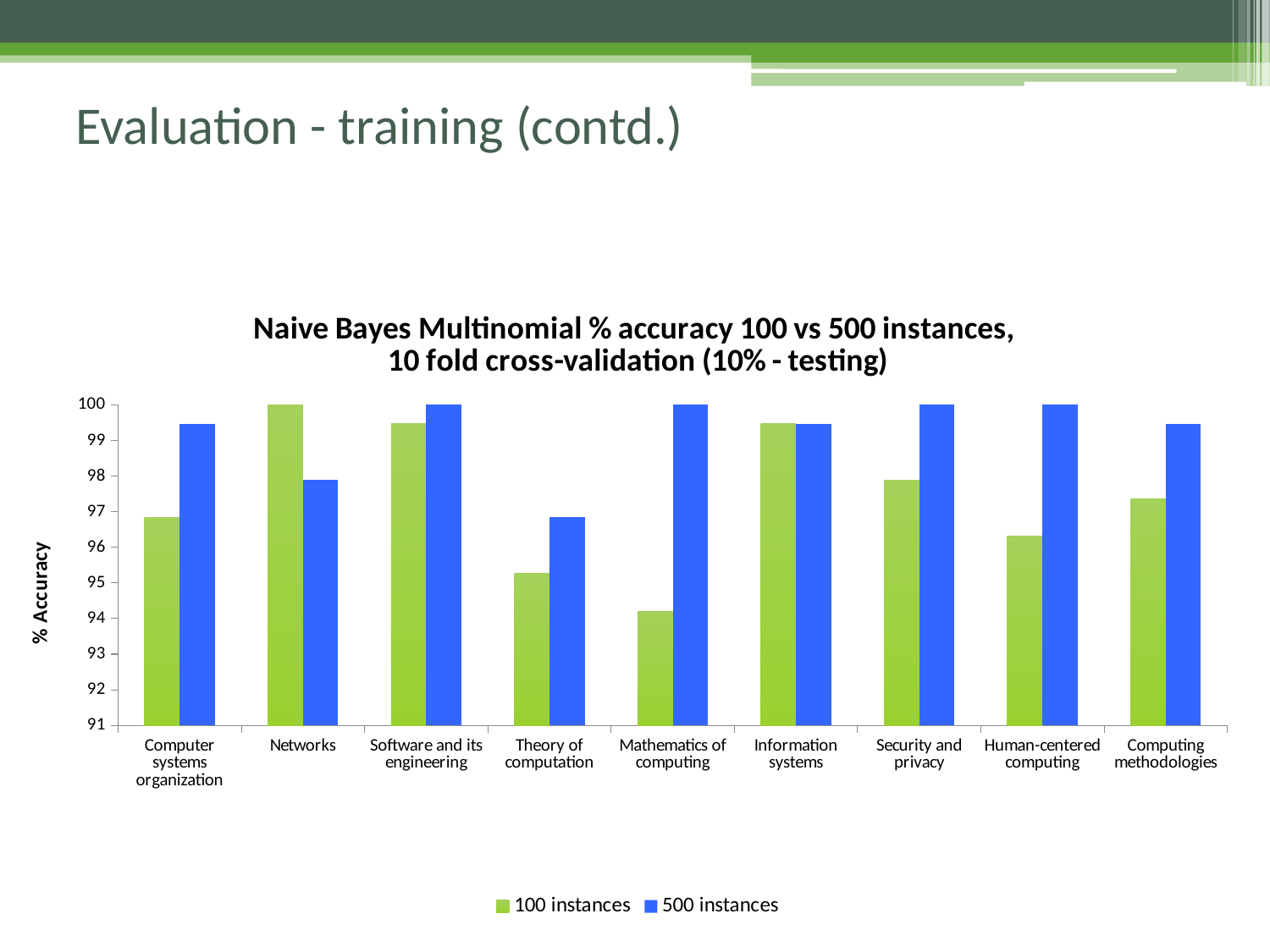
For Human-centered computing, which is larger: 100 instances or 500 instances? 500 instances Which category has the lowest % accuracy for 500 instances? Theory of computation What is the label of the y axis? % Accuracy What is the % accuracy for Mathematics of computing with 500 instances? 100 For Networks, which is larger: 100 instances or 500 instances? 100 instances Is the value for Theory of computation with 100 instances greater or less than 96? less Is the value for Computer systems organization with 500 instances greater or less than 99? greater How many categories are shown on the x axis? 9 What type of chart is shown on the slide? bar chart What is the % accuracy for Networks with 100 instances? 100 Which category has the lowest % accuracy for 100 instances? Mathematics of computing How many series does the legend list? 2